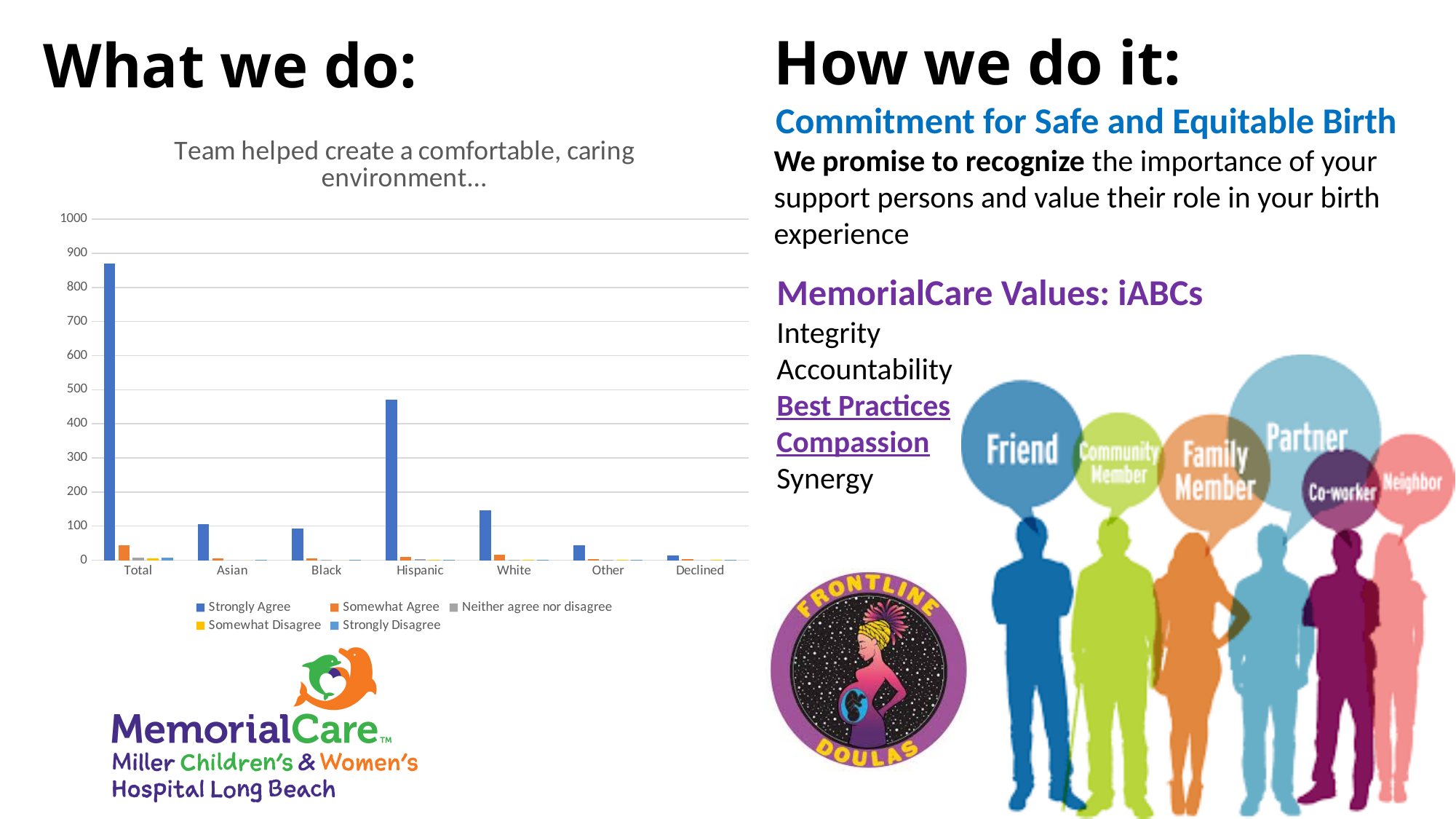
Which has a larger Strongly Agree value, Hispanic or White? Hispanic Is the Strongly Agree value for White greater or less than 200? less Is the Strongly Agree value for Total greater or less than 800? greater Which series is listed first in the chart's legend? Strongly Agree How many categories are shown on the x axis of the chart? 7 Is the Strongly Agree value for Hispanic greater or less than 500? less What kind of chart is shown on the slide? bar chart What is the title of the chart? Team helped create a comfortable, caring environment... How many series does the chart's legend list? 5 Which category has the tallest Strongly Agree bar? Total Excluding Total, which category has the tallest Strongly Agree bar? Hispanic